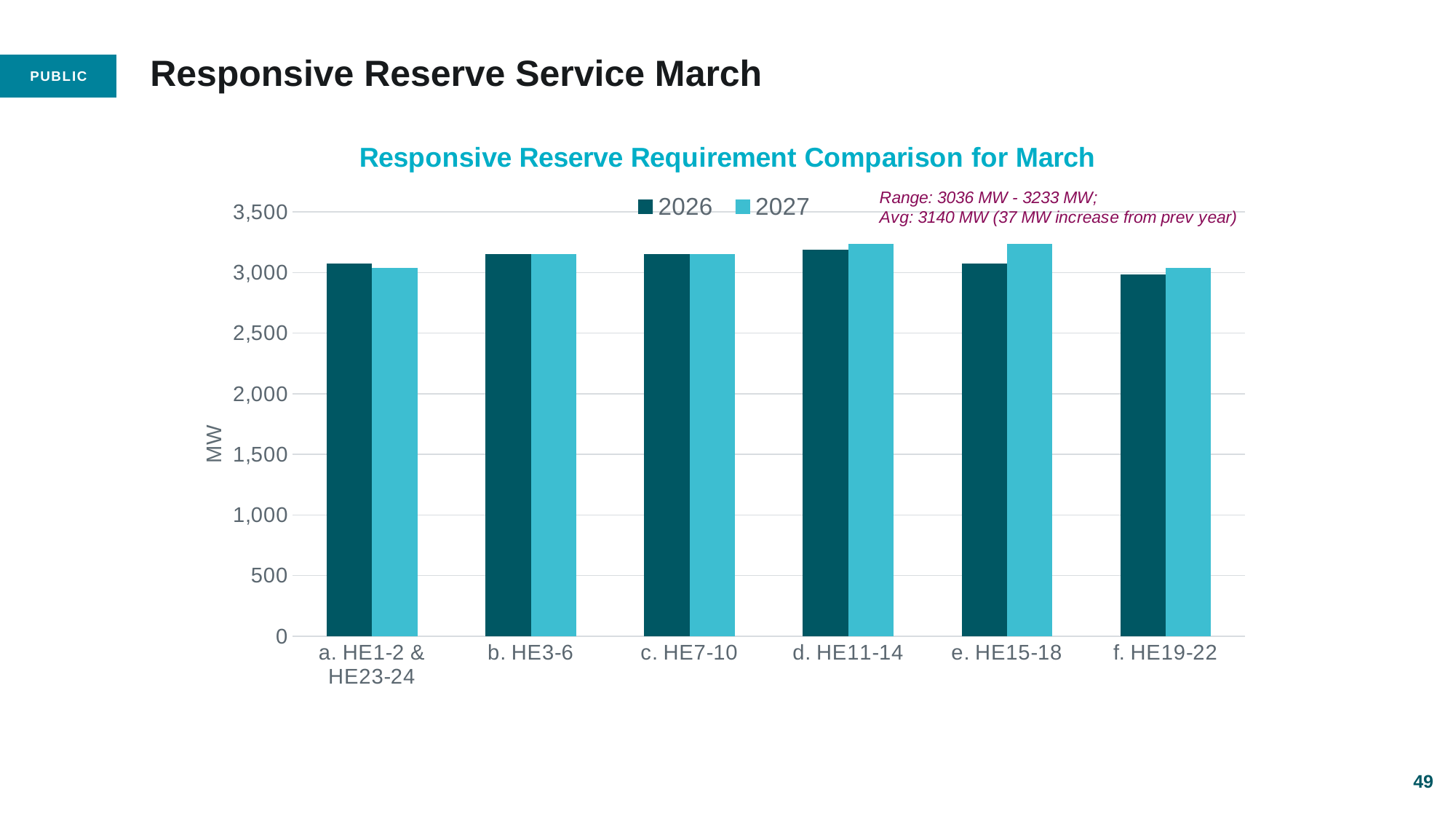
What is the title of the chart? Responsive Reserve Requirement Comparison for March For d. HE11-14, which series has the larger value, 2026 or 2027? 2027 Is the 2027 value for d. HE11-14 greater or less than 3,500? less For e. HE15-18, which series has the larger value, 2026 or 2027? 2027 What kind of chart is shown on the slide? Bar chart What are the two series listed in the chart's legend? 2026 and 2027 Is the 2026 value for b. HE3-6 greater or less than 3,000? greater Is the 2026 value for f. HE19-22 greater or less than 2,500? greater Which category has the lowest value for the 2026 series? f. HE19-22 How many categories are shown on the x axis of the chart? 6 How many series does the chart's legend list? 2